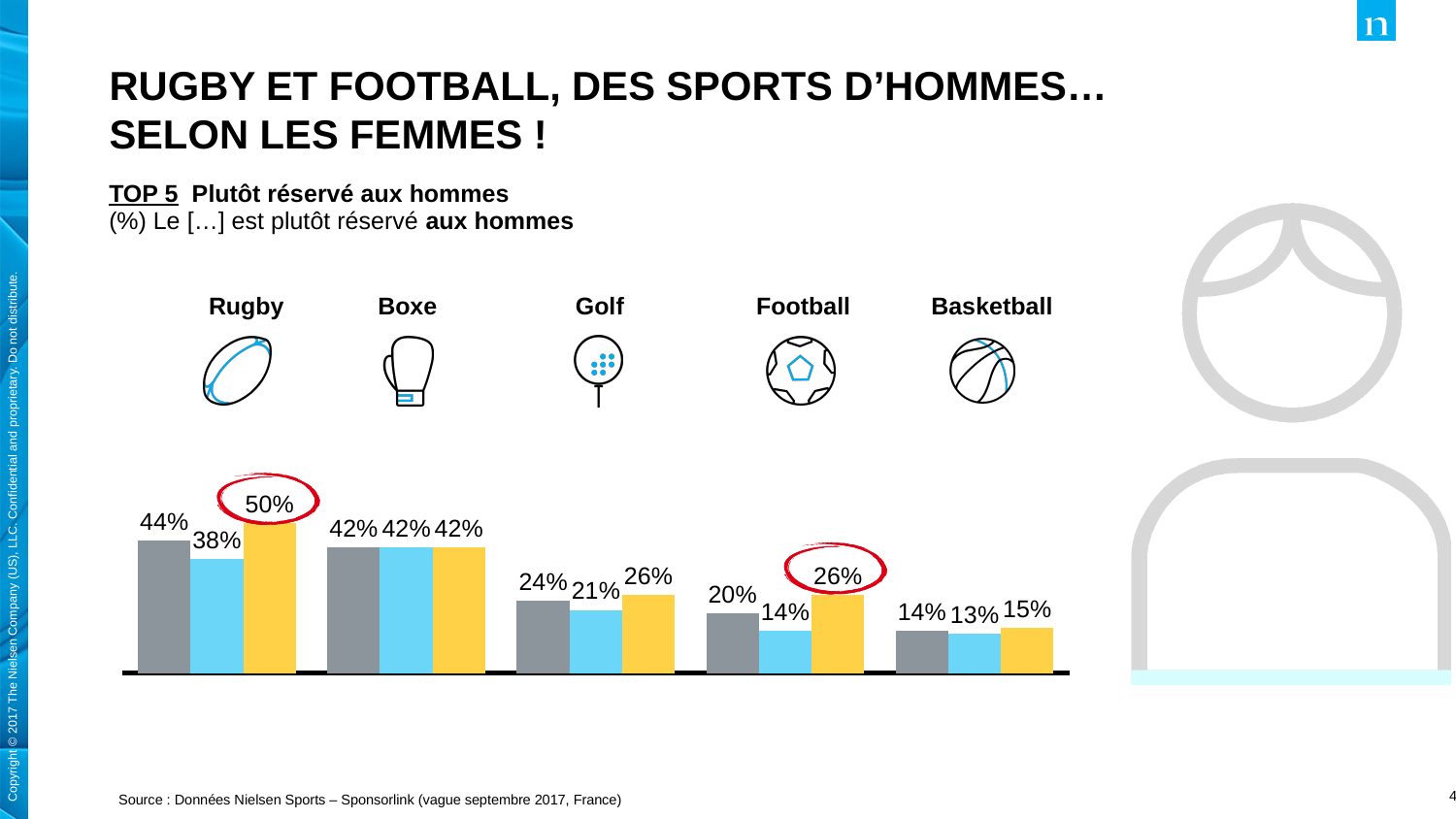
What is the difference between the grey bar for Rugby and the grey bar for Boxe? 2% Which is larger: the blue bar for Rugby or the blue bar for Boxe? Boxe Which sport has the lowest value for the grey bar? Basketball How many sports are shown in the chart? 5 What type of chart is shown on the slide? Bar chart Which two values on the chart are circled in red? 50% (Rugby) and 26% (Football) Which sport has the highest value for the yellow bar? Rugby What is the value of the blue bar for Basketball? 13% What is the value of the yellow bar for Rugby? 50% What is the difference between the yellow bar and the blue bar for Football? 12% What is the value of the blue bar for Golf? 21% What is the value of the grey bar for Football? 20%